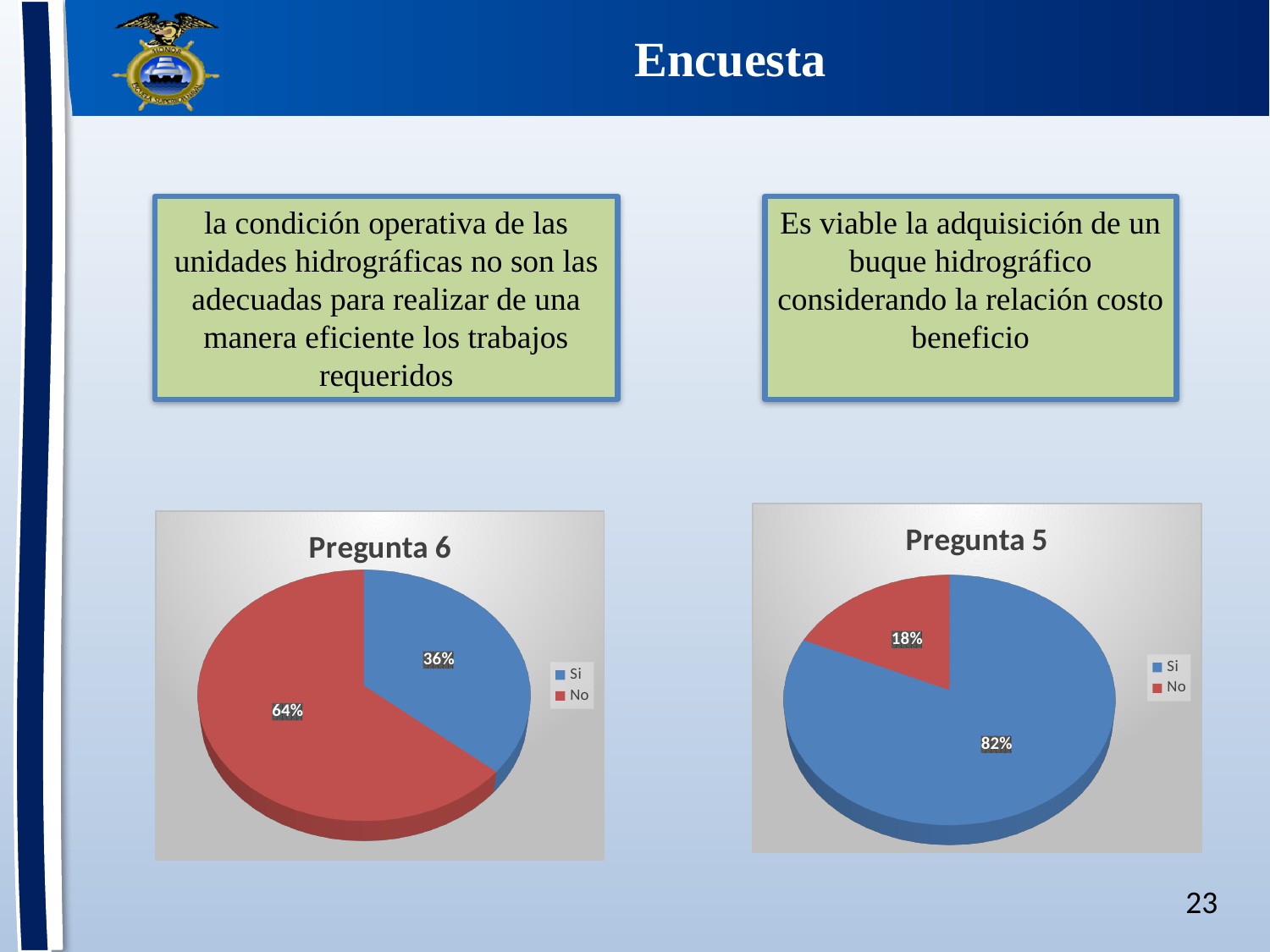
In the Pregunta 6 chart, which is larger, Si or No? No In the Pregunta 5 chart, what percentage is shown for No? 18% In the Pregunta 6 chart, what percentage is shown for No? 64% In the Pregunta 5 chart, what percentage is shown for Si? 82% What kind of chart is the Pregunta 5 chart? Pie chart In the Pregunta 5 chart, what is the difference in percentage points between Si and No? 64 In the Pregunta 6 chart, which category has the largest slice? No In the Pregunta 6 chart, what percentage is shown for Si? 36% How many entries does the legend of the Pregunta 6 chart list? 2 In the Pregunta 5 chart, what colour is the Si slice? Blue In the Pregunta 6 chart, what is the difference in percentage points between No and Si? 28 In the Pregunta 5 chart, which category has the smallest slice? No